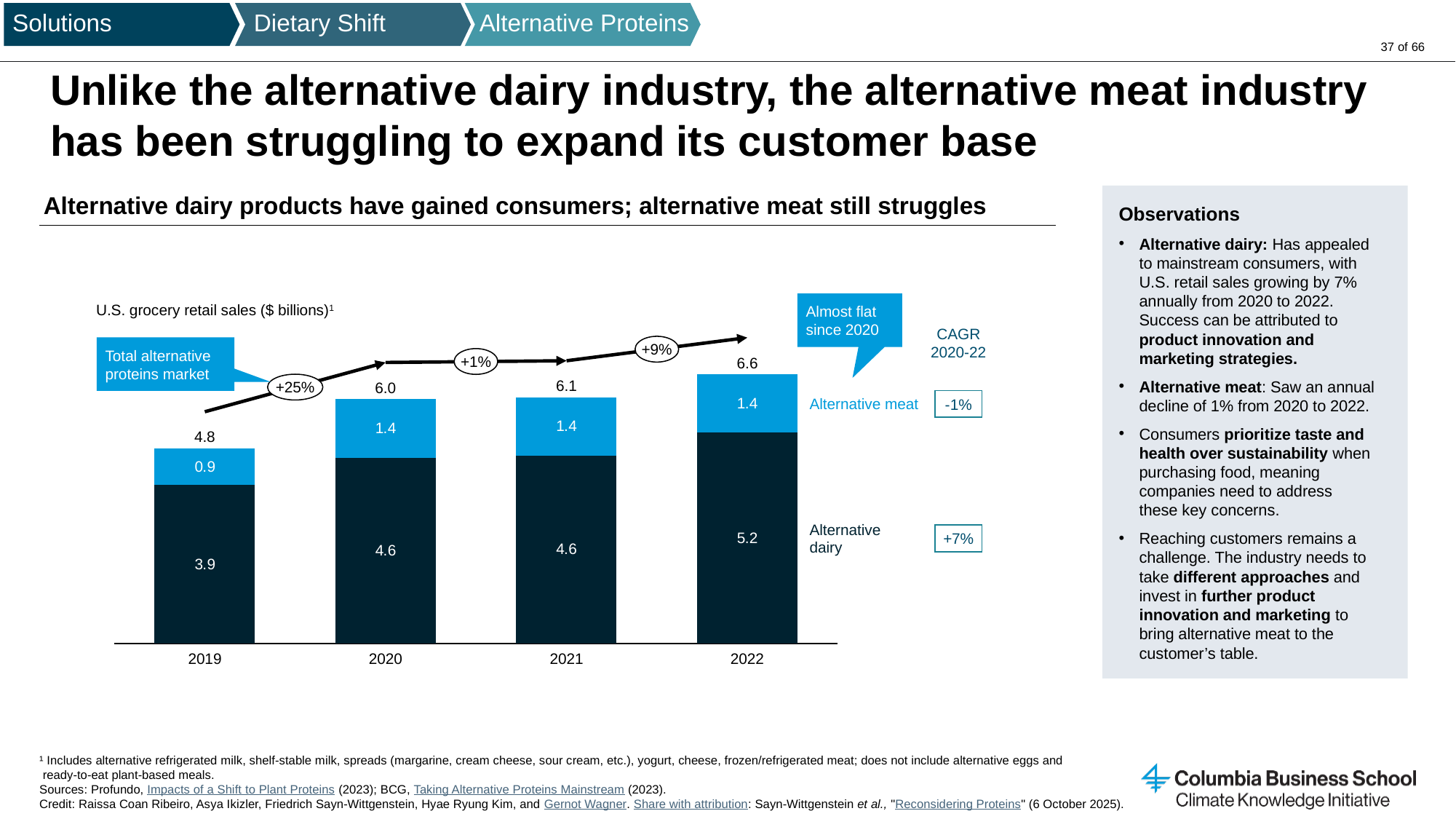
Which is larger, the alternative meat value in 2019 or in 2020? 2020 How many years are shown on the x axis? 4 What is the difference between the alternative dairy values in 2022 and 2021? 0.6 What kind of chart is this? Stacked bar chart Does the total alternative proteins market rise or fall from 2019 to 2022? Rise What growth rate is shown between 2019 and 2020 for the total alternative proteins market? +25% What was the alternative meat value in 2022? 1.4 Which year has the lowest alternative dairy value? 2019 Which year has the highest total alternative proteins market value? 2022 What is the CAGR 2020-22 shown for alternative meat? -1% What was the alternative dairy value in 2019? 3.9 What is the total alternative proteins market value shown for 2021? 6.1